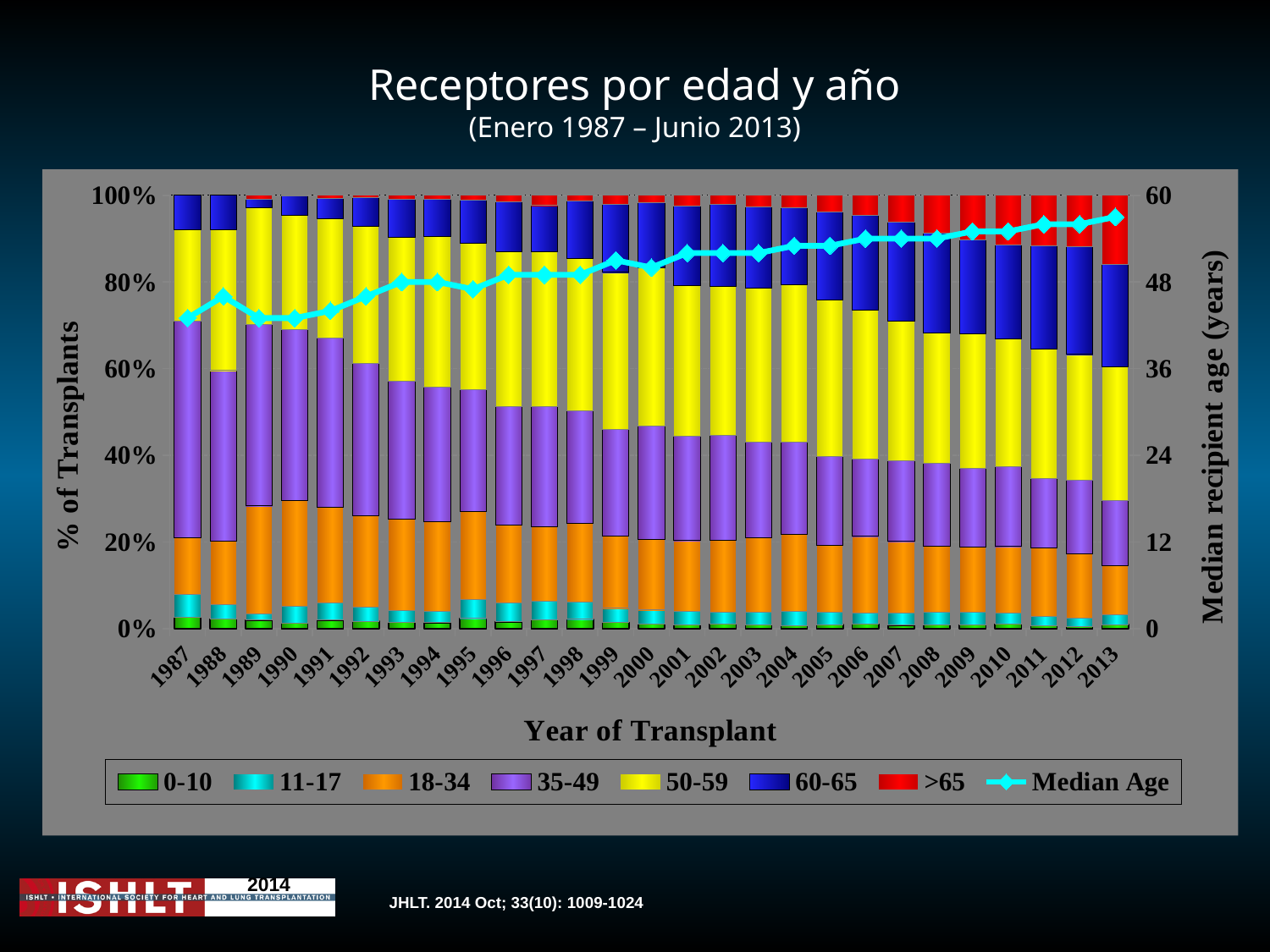
Is the Median Age in 2013 greater or less than 48 years? greater What kind of chart is shown on the slide? Stacked bar chart with a line What is the title of the chart's x axis? Year of Transplant Which year has the highest Median Age? 2013 Which year has the larger Median Age, 1987 or 2013? 2013 Which year has the larger share of 35-49 recipients, 1987 or 2013? 1987 How many entries does the chart's legend list? 8 How many years are shown along the x axis of the chart? 27 Is the Median Age in 1987 greater or less than 48 years? less What is the title of the right-hand y axis? Median recipient age (years) Does the Median Age line rise or fall from 1987 to 2013? Rise Does the share of >65 recipients rise or fall across the years from 1987 to 2013? Rise